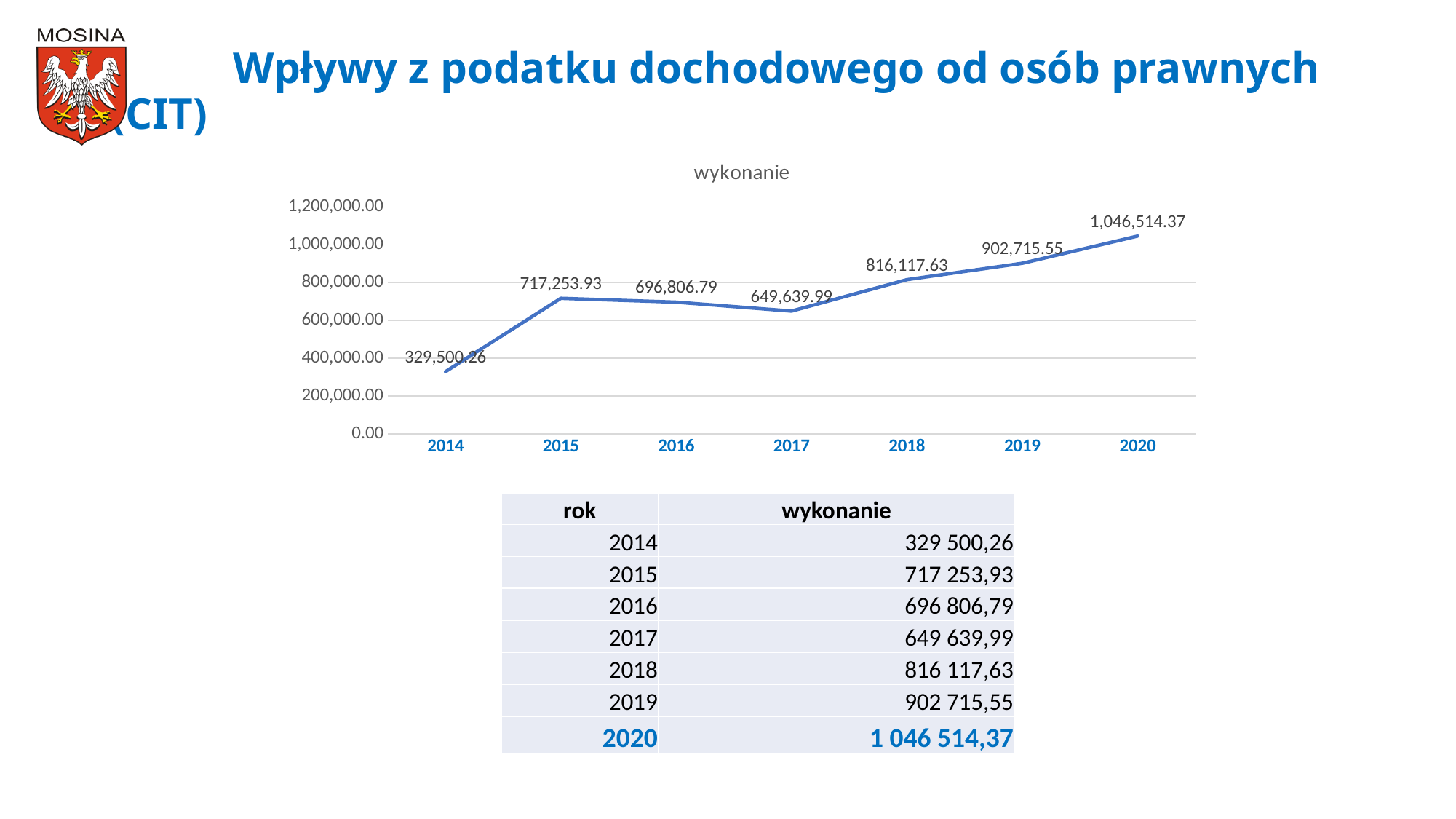
Is the value for 2018 greater or less than 800,000.00? greater What is the difference between the values for 2015 and 2014? 387,753.67 What is the title of the chart? wykonanie What is the value for 2017 in the chart? 649,639.99 What is the value for 2020 in the chart? 1,046,514.37 How many years are plotted in the chart? 7 What kind of chart is shown on the slide? line chart Which year has the lowest value in the chart? 2014 What is the value for 2014 in the chart? 329,500.26 What is the difference between the values for 2020 and 2019? 143,798.82 Which is larger, the value for 2015 or the value for 2016? 2015 Which year has the highest value in the chart? 2020